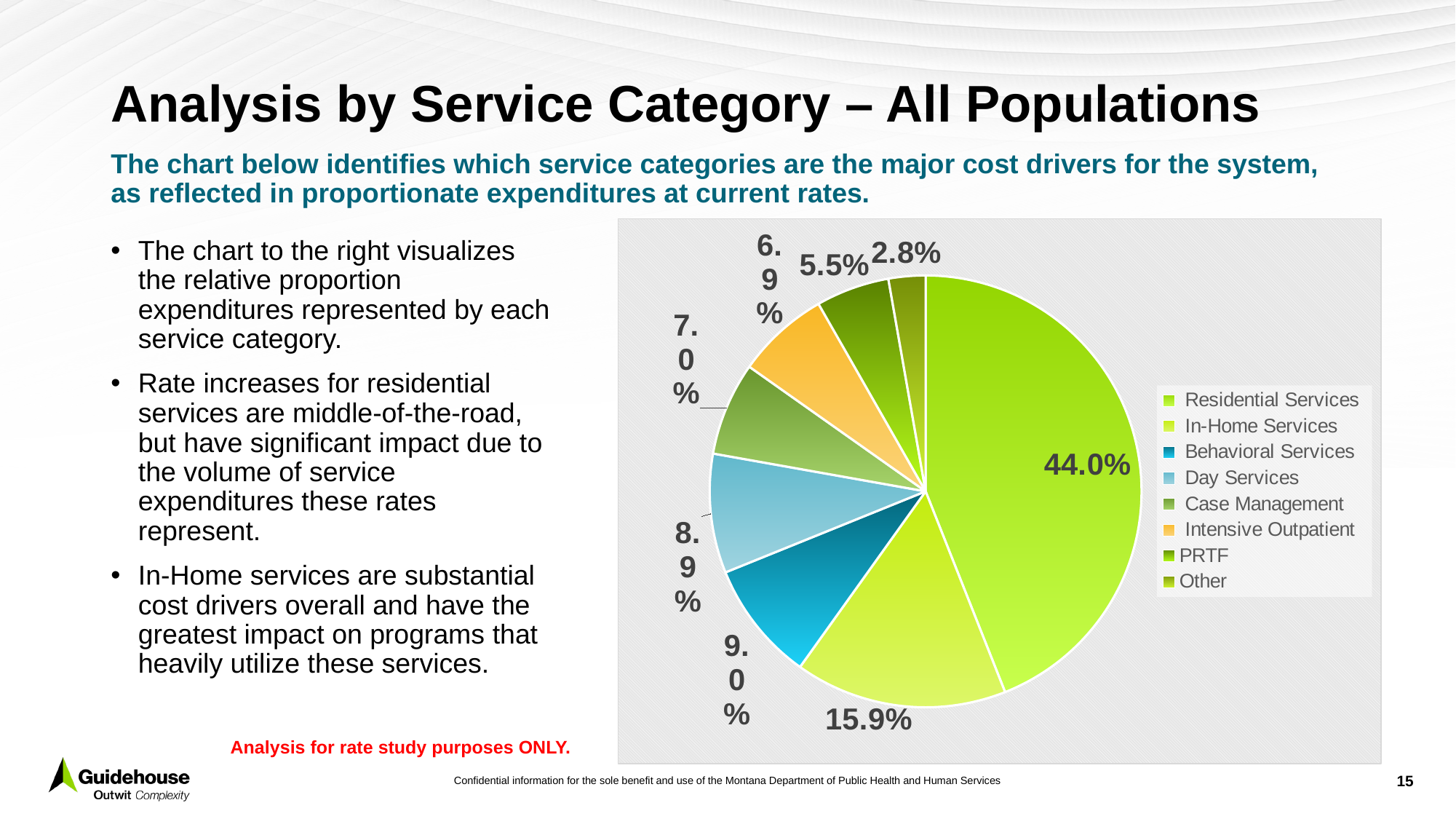
What share of expenditures does Behavioral Services represent? 9.0% Which service category has the largest share of the pie? Residential Services Which is larger, the share for Day Services or the share for Case Management? Day Services What share of expenditures does PRTF represent? 5.5% What is the difference in percentage points between Residential Services and In-Home Services? 28.1 What share of expenditures does Residential Services represent? 44.0% Which service category has the smallest share of the pie? Other What type of chart is shown on the slide? Pie chart What share of expenditures does Intensive Outpatient represent? 6.9% What share of expenditures does In-Home Services represent? 15.9% How many service categories are listed in the legend? 8 What colour is the Behavioral Services slice? Blue